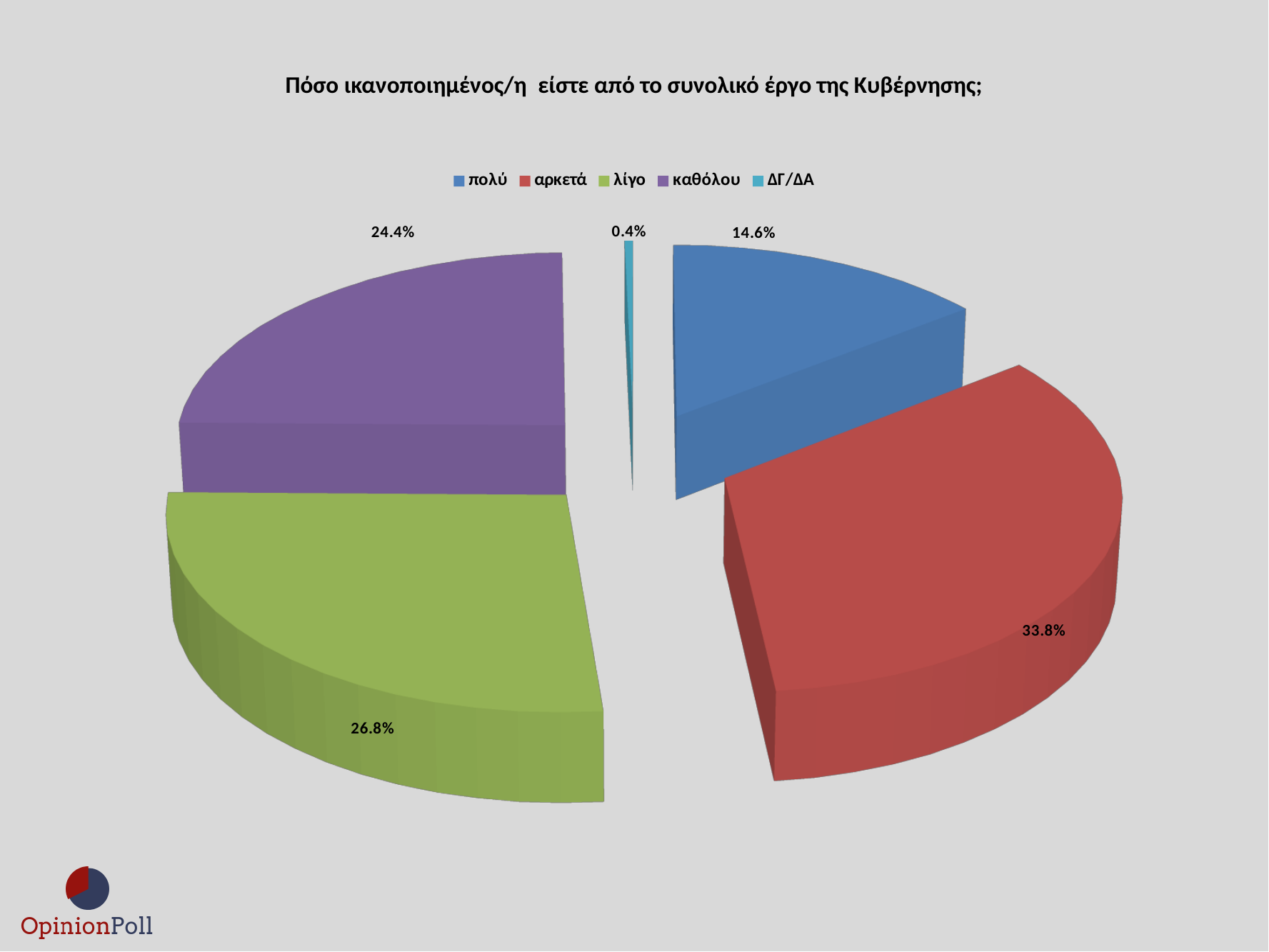
What percentage of respondents answered "ΔΓ/ΔΑ"? 0.4% What colour is the slice for "καθόλου"? Purple How many categories does the legend list? 5 Which response category has the smallest share of the pie? ΔΓ/ΔΑ What percentage of respondents answered "αρκετά"? 33.8% What is the difference in percentage points between "αρκετά" and "πολύ"? 19.2 What percentage of respondents answered "καθόλου"? 24.4% Which is larger, the share for "λίγο" or the share for "καθόλου"? λίγο What percentage of respondents answered "λίγο"? 26.8% What percentage of respondents answered "πολύ"? 14.6% Which response category has the largest share of the pie? αρκετά What kind of chart is shown on the slide? Pie chart